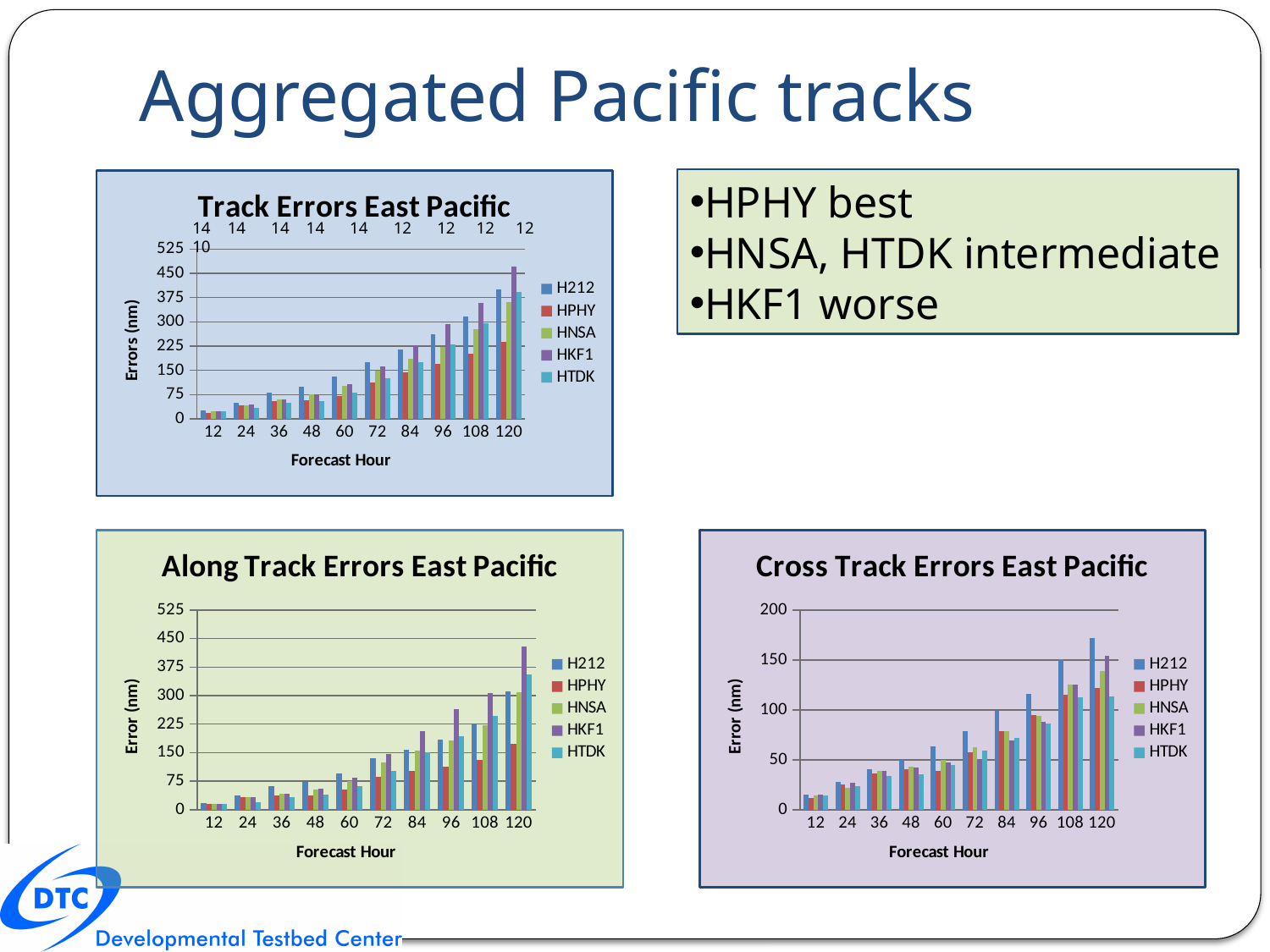
In the Along Track Errors East Pacific chart, which series has the highest value at forecast hour 120? HKF1 In the Along Track Errors East Pacific chart, is the value for HPHY at forecast hour 120 greater or less than 225? less How many series does the legend of the Along Track Errors East Pacific chart list? 5 In the Track Errors East Pacific chart, which series has the highest value at forecast hour 120? HKF1 In the Track Errors East Pacific chart, is the value for HPHY at forecast hour 120 greater or less than 300? less In the Track Errors East Pacific chart, do the errors generally rise or fall as the forecast hour increases? rise How many forecast hours are shown on the x axis of the Cross Track Errors East Pacific chart? 10 In the Track Errors East Pacific chart, which is larger at forecast hour 120, HKF1 or HPHY? HKF1 In the Cross Track Errors East Pacific chart, is the value for HPHY at forecast hour 120 greater or less than 100? greater What kind of chart is the Track Errors East Pacific chart? bar chart In the Cross Track Errors East Pacific chart, which series has the highest value at forecast hour 120? H212 What is the title of the chart in the bottom right of the slide? Cross Track Errors East Pacific